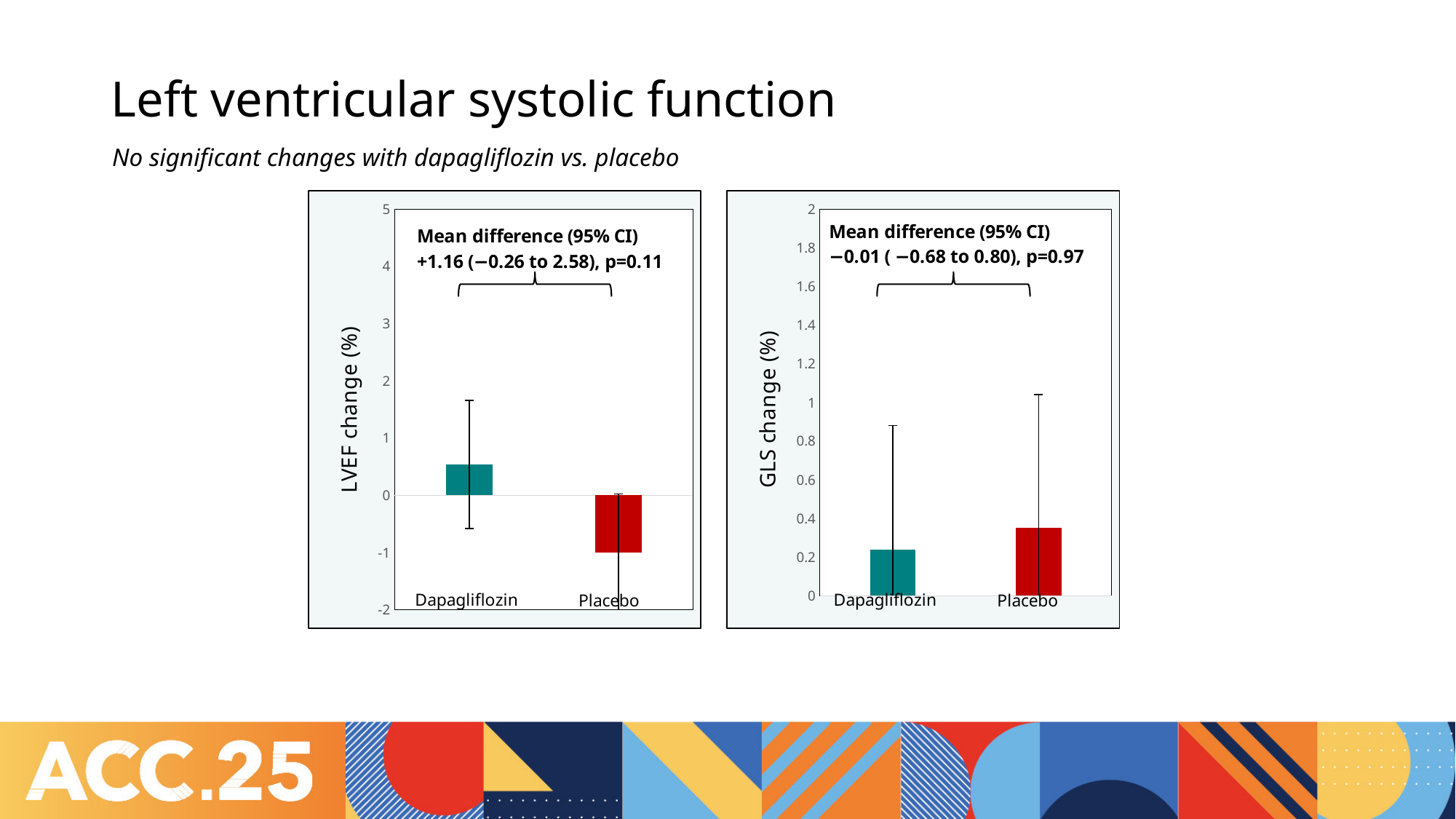
In the right chart (GLS change), is the value for Dapagliflozin greater or less than 0.4? less In the right chart (GLS change), what is the mean difference (95% CI) stated on the chart? −0.01 (−0.68 to 0.80) What kind of chart is the left chart (LVEF change)? bar chart In the left chart (LVEF change), is the value for Placebo greater or less than 0? less In the left chart (LVEF change), how many categories are shown on the x axis? 2 In the left chart (LVEF change), is the value for Dapagliflozin greater or less than 0? greater In the right chart (GLS change), which category has the highest value? Placebo In the right chart (GLS change), which category has the lowest value? Dapagliflozin In the left chart (LVEF change), what p-value is given for the mean difference? p=0.11 In the left chart (LVEF change), which category has the higher value, Dapagliflozin or Placebo? Dapagliflozin